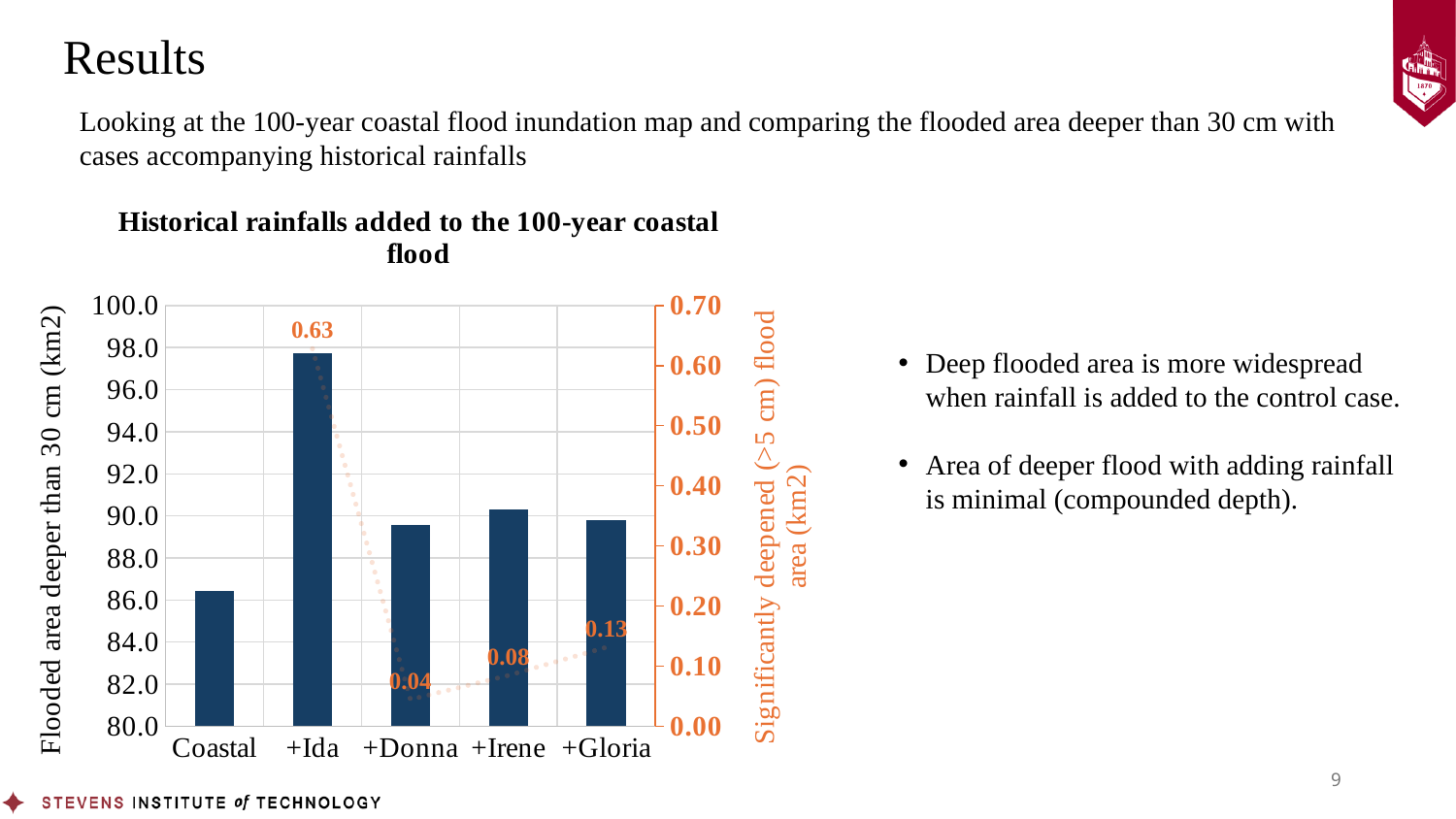
What is the significantly deepened (>5 cm) flood area value labelled for +Donna? 0.04 Is the flooded area deeper than 30 cm for +Ida greater or less than 96.0 km2? greater Which category has the lowest labelled significantly deepened flood area value? +Donna Is the flooded area deeper than 30 cm for Coastal greater or less than 88.0 km2? less What is the difference between the significantly deepened flood area values for +Gloria and +Irene? 0.05 What is the significantly deepened (>5 cm) flood area value labelled for +Ida? 0.63 What is the title of the chart? Historical rainfalls added to the 100-year coastal flood Which category has the tallest bar for flooded area deeper than 30 cm? +Ida How many categories are shown on the x axis of the chart? 5 Which category has the shortest bar for flooded area deeper than 30 cm? Coastal What is the significantly deepened (>5 cm) flood area value labelled for +Gloria? 0.13 What is the difference between the significantly deepened flood area values for +Ida and +Donna? 0.59